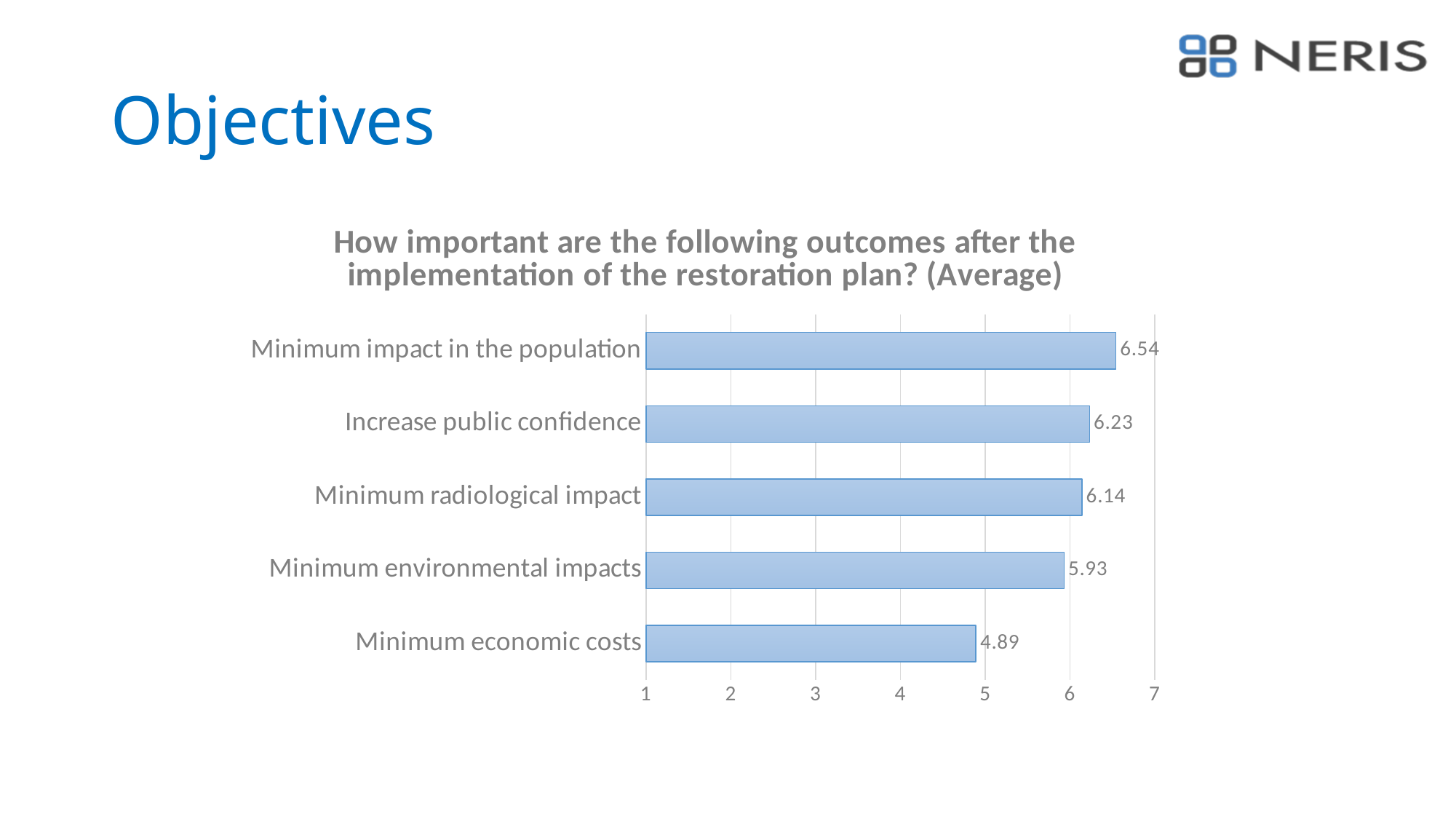
What kind of chart is shown on the slide? Bar chart What is the average importance value for 'Minimum economic costs'? 4.89 Is the value for 'Minimum economic costs' greater or less than 5? less Which has a larger value: 'Increase public confidence' or 'Minimum environmental impacts'? Increase public confidence What is the average importance value for 'Minimum impact in the population'? 6.54 How many outcomes are shown in the chart? 5 Which outcome has the highest average importance? Minimum impact in the population Which outcome has the lowest average importance? Minimum economic costs What is the difference between the values for 'Minimum impact in the population' and 'Minimum economic costs'? 1.65 What is the difference between the values for 'Increase public confidence' and 'Minimum radiological impact'? 0.09 What is the average importance value for 'Minimum environmental impacts'? 5.93 What is the title of the chart? How important are the following outcomes after the implementation of the restoration plan? (Average)